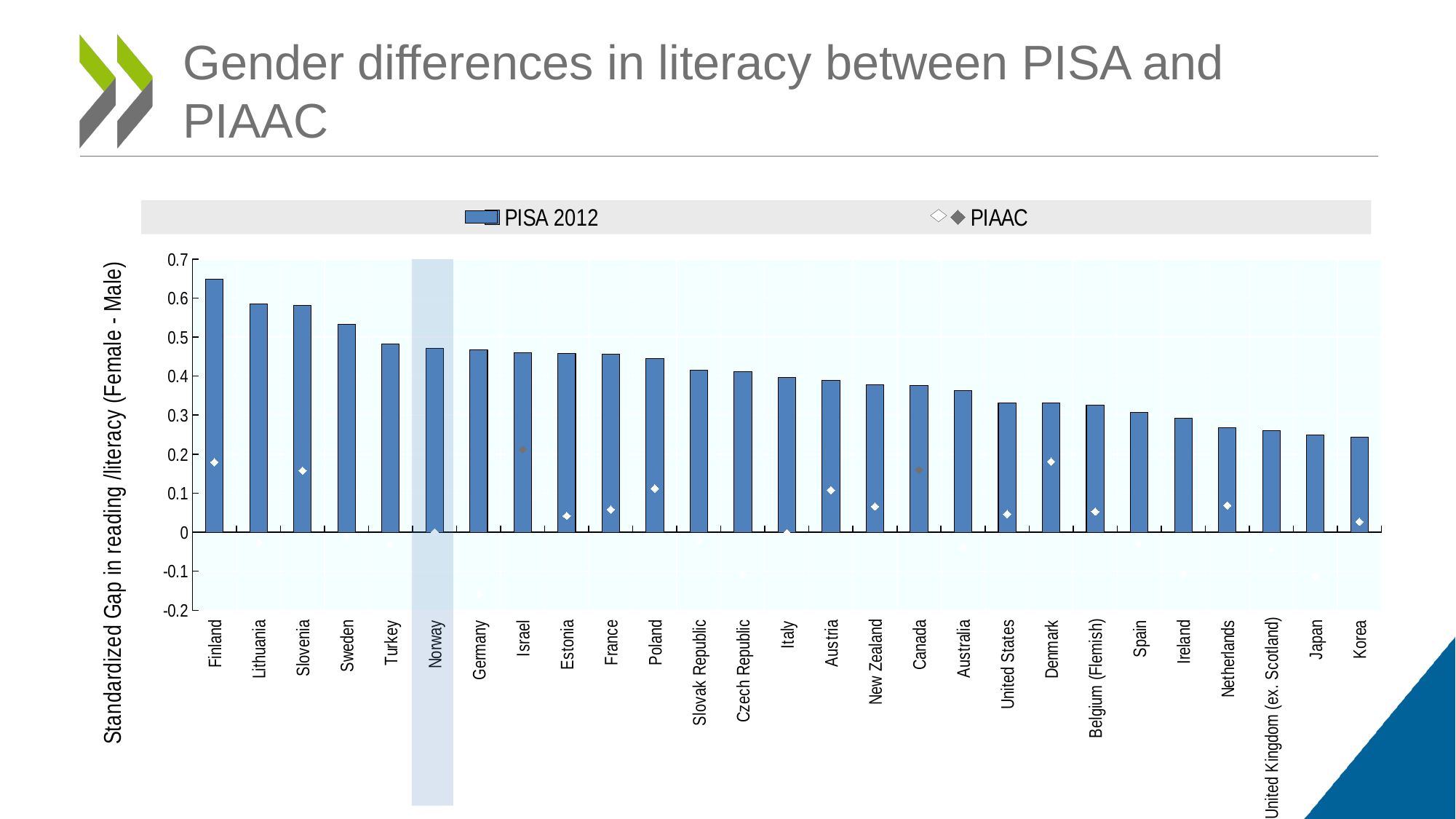
Which country is highlighted with a shaded column in the chart? Norway Which country has the lowest PISA 2012 bar? Korea What kind of chart is shown on the slide? bar chart Is the PIAAC value for Estonia greater or less than 0.1? less How many series does the legend list? 2 Is the PISA 2012 value for Korea greater or less than 0.3? less Which has the larger PISA 2012 value, Sweden or Turkey? Sweden Is the PIAAC value for Germany greater or less than 0? less Do the PISA 2012 bars rise or fall from left to right along the x axis? fall How many countries are shown on the x axis? 27 Which country has the highest PISA 2012 bar? Finland